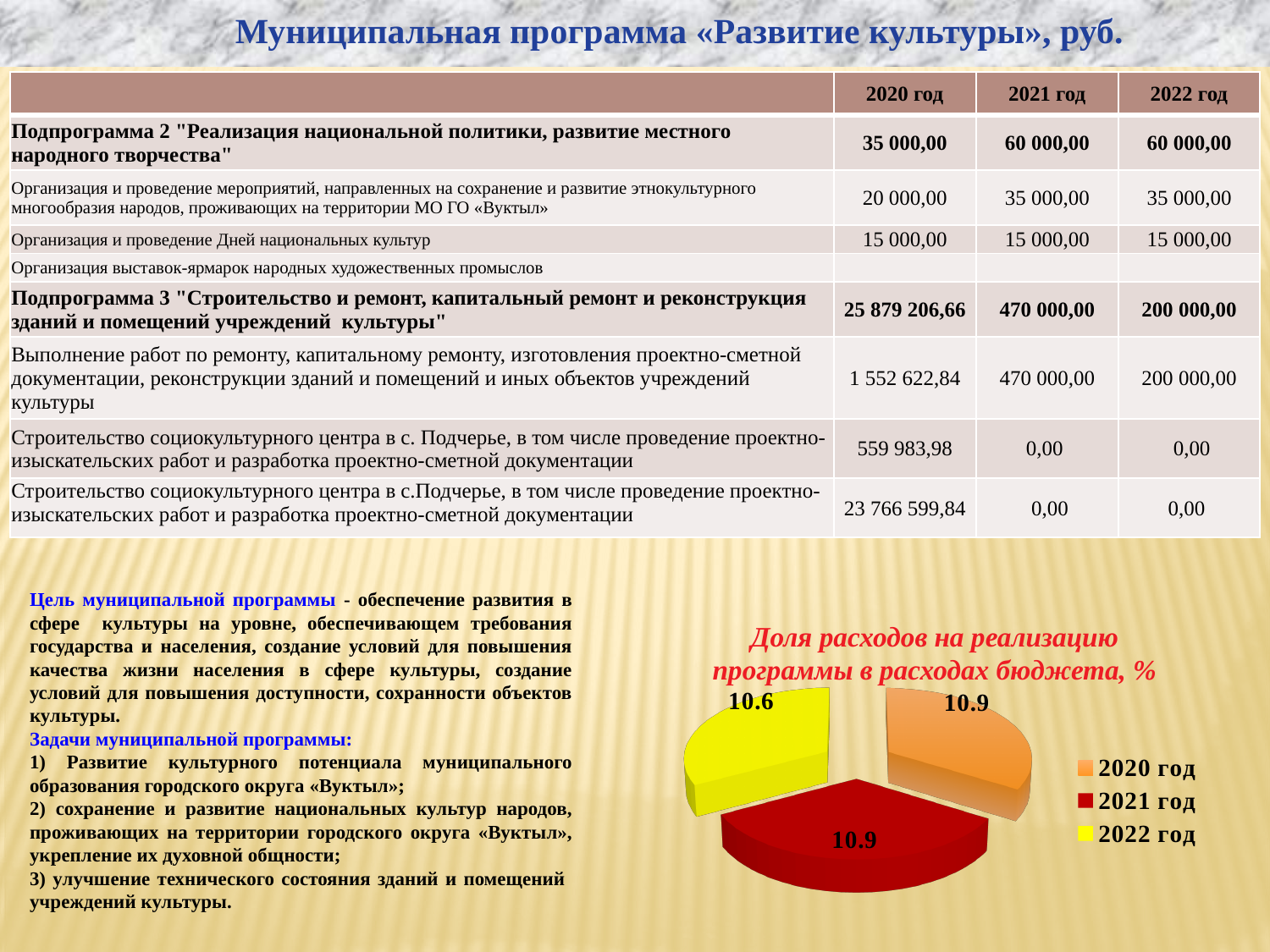
What is the value for 2020 год in the pie chart? 10.9 What kind of chart is shown on the slide? pie chart Which year has the lowest value in the pie chart? 2022 год What is the difference between the values for 2021 год and 2022 год in the pie chart? 0.3 What is the value for 2021 год in the pie chart? 10.9 What is the title of the pie chart? Доля расходов на реализацию программы в расходах бюджета, % How many slices does the pie chart have? 3 What is the value for 2022 год in the pie chart? 10.6 How many entries does the pie chart legend list? 3 What colour is the slice for 2022 год in the pie chart? yellow Which is larger in the pie chart, the value for 2020 год or for 2022 год? 2020 год